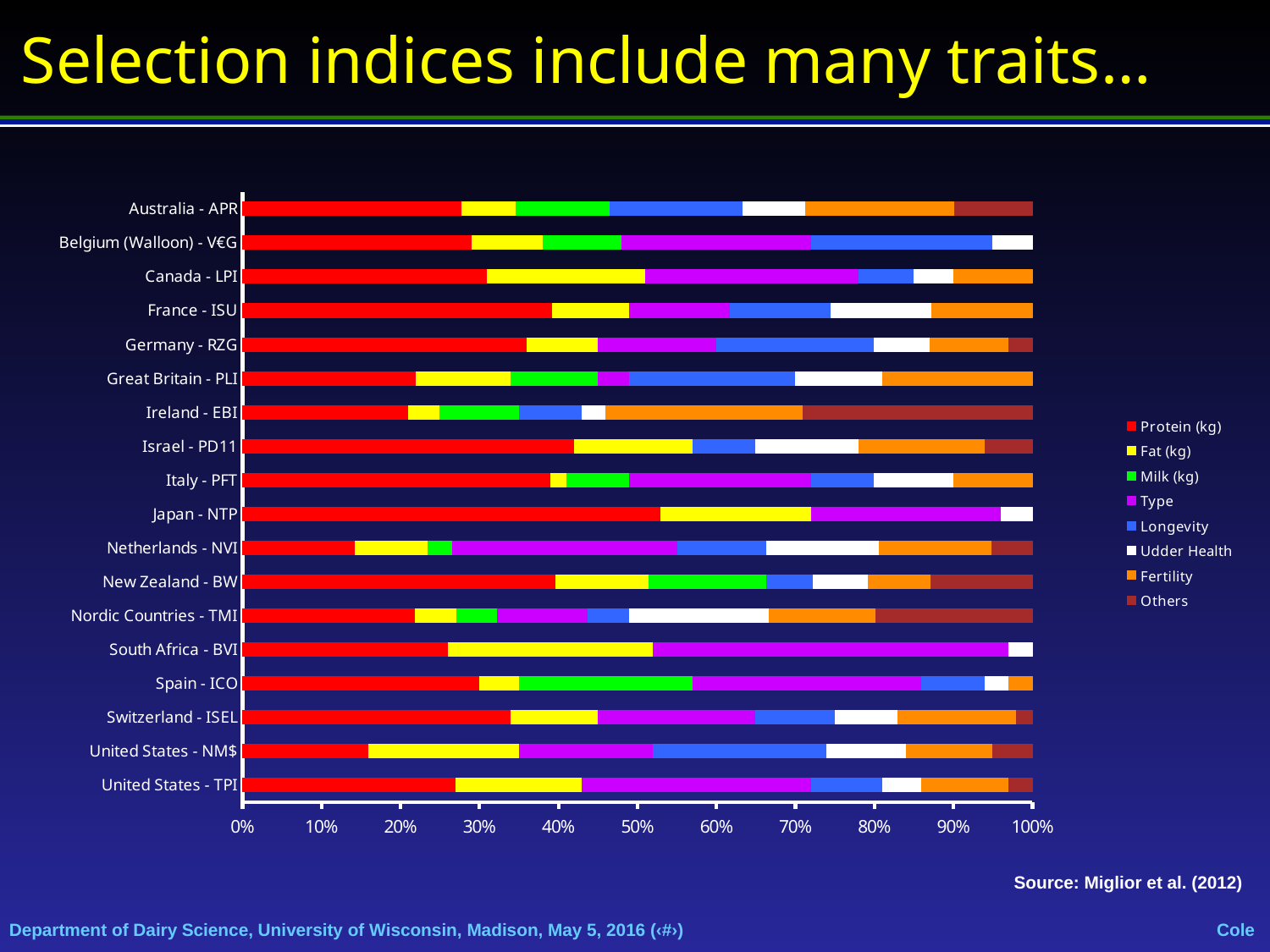
Is the Protein (kg) share for Netherlands - NVI greater or less than 20%? less Which series is listed first in the chart legend? Protein (kg) What kind of chart is shown on the slide? Stacked bar chart Which series is listed last in the chart legend? Others Is the Protein (kg) share for Germany - RZG greater or less than 30%? greater Is the Protein (kg) share for Japan - NTP greater or less than 50%? greater How many series does the chart legend list? 8 Which index has the highest Protein (kg) share? Japan - NTP How many country/index categories are plotted on the chart? 18 Which index has the larger Protein (kg) share, Japan - NTP or Netherlands - NVI? Japan - NTP